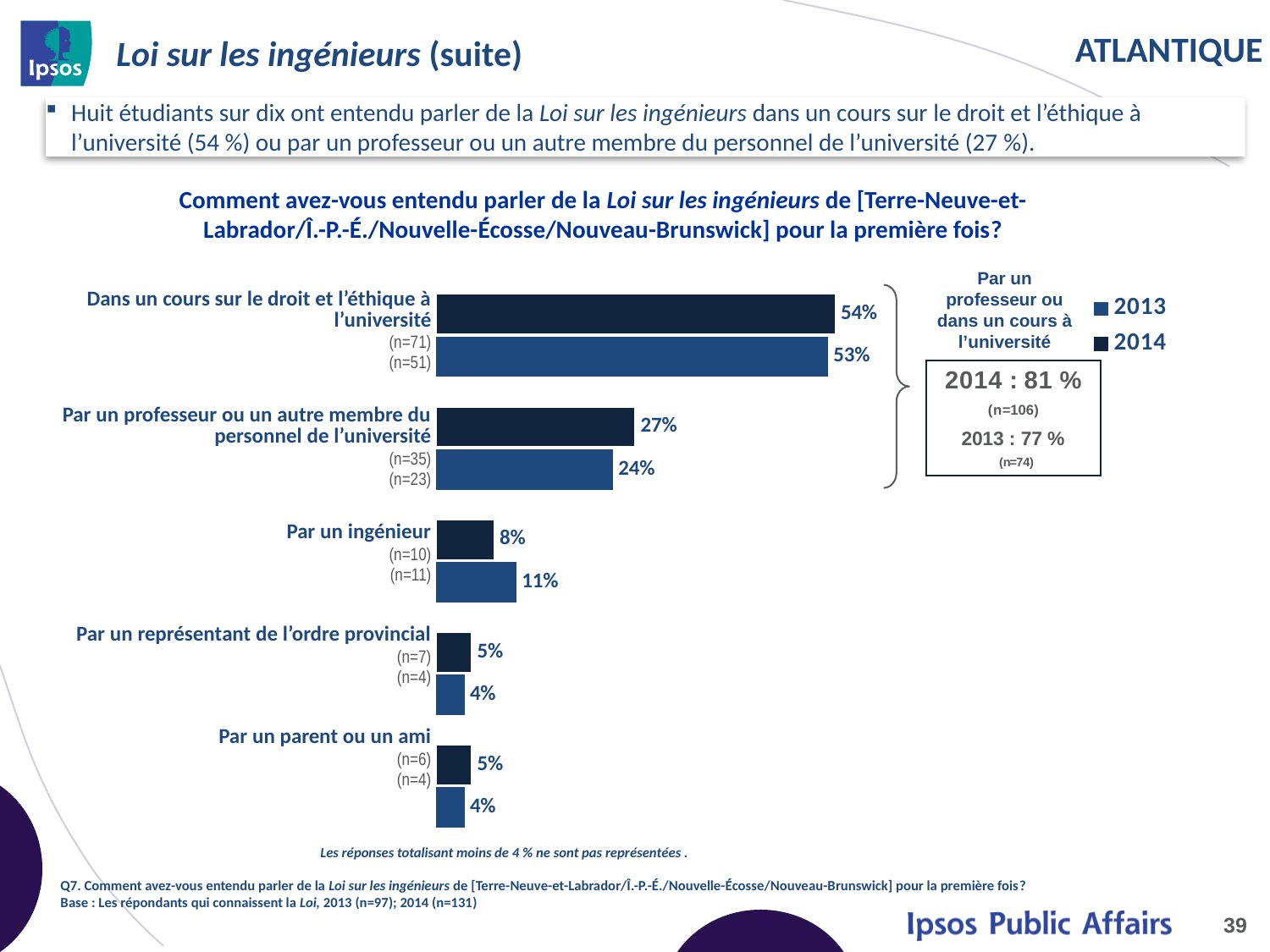
What is the difference between the two bars for 'Par un professeur ou un autre membre du personnel de l'université' (27% and 24%)? 3 percentage points Which category has larger values: 'Par un ingénieur' or 'Par un représentant de l'ordre provincial'? Par un ingénieur What are the two values shown for 'Par un ingénieur'? 8% and 11% What is the difference between the two bars for 'Dans un cours sur le droit et l'éthique à l'université' (54% and 53%)? 1 percentage point What is the 2014 value for 'Par un professeur ou un autre membre du personnel de l'université'? 27% What type of chart is shown on the slide? Bar chart How many response categories are plotted in the chart? 5 What is the 2014 value for 'Dans un cours sur le droit et l'éthique à l'université'? 54% How many series does the chart legend list? 2 According to the box on the right, what is the combined 2014 percentage for 'Par un professeur ou dans un cours à l'université'? 81 % Which category has the highest values in the chart? Dans un cours sur le droit et l'éthique à l'université What are the two entries in the chart legend? 2013 and 2014